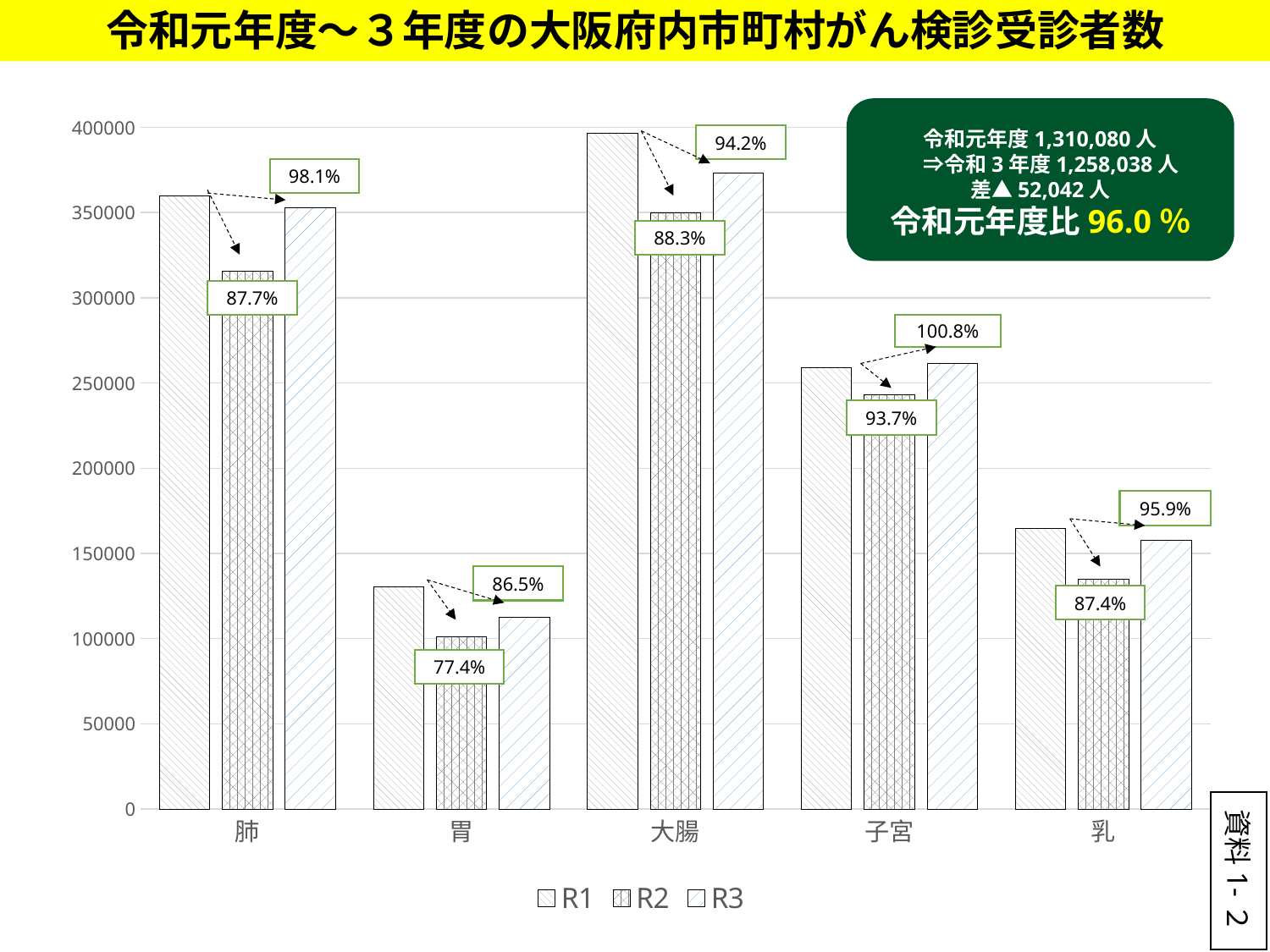
How many categories are shown on the x axis of the chart? 5 What percentage label is shown for the R3 bar of 肺? 98.1% What percentage label is shown for the R2 bar of 胃? 77.4% How many series does the chart's legend list? 3 Which is larger, the R1 value for 乳 or the R1 value for 胃? 乳 Is the R1 value for 大腸 greater or less than 400000? less Is the R3 value for 乳 greater or less than 200000? less Which category has the highest R1 value? 大腸 Which category has the lowest R1 value? 胃 Which is larger, the R1 value for 肺 or the R1 value for 大腸? 大腸 What kind of chart is shown on the slide? bar chart Is the R1 value for 肺 greater or less than 350000? greater